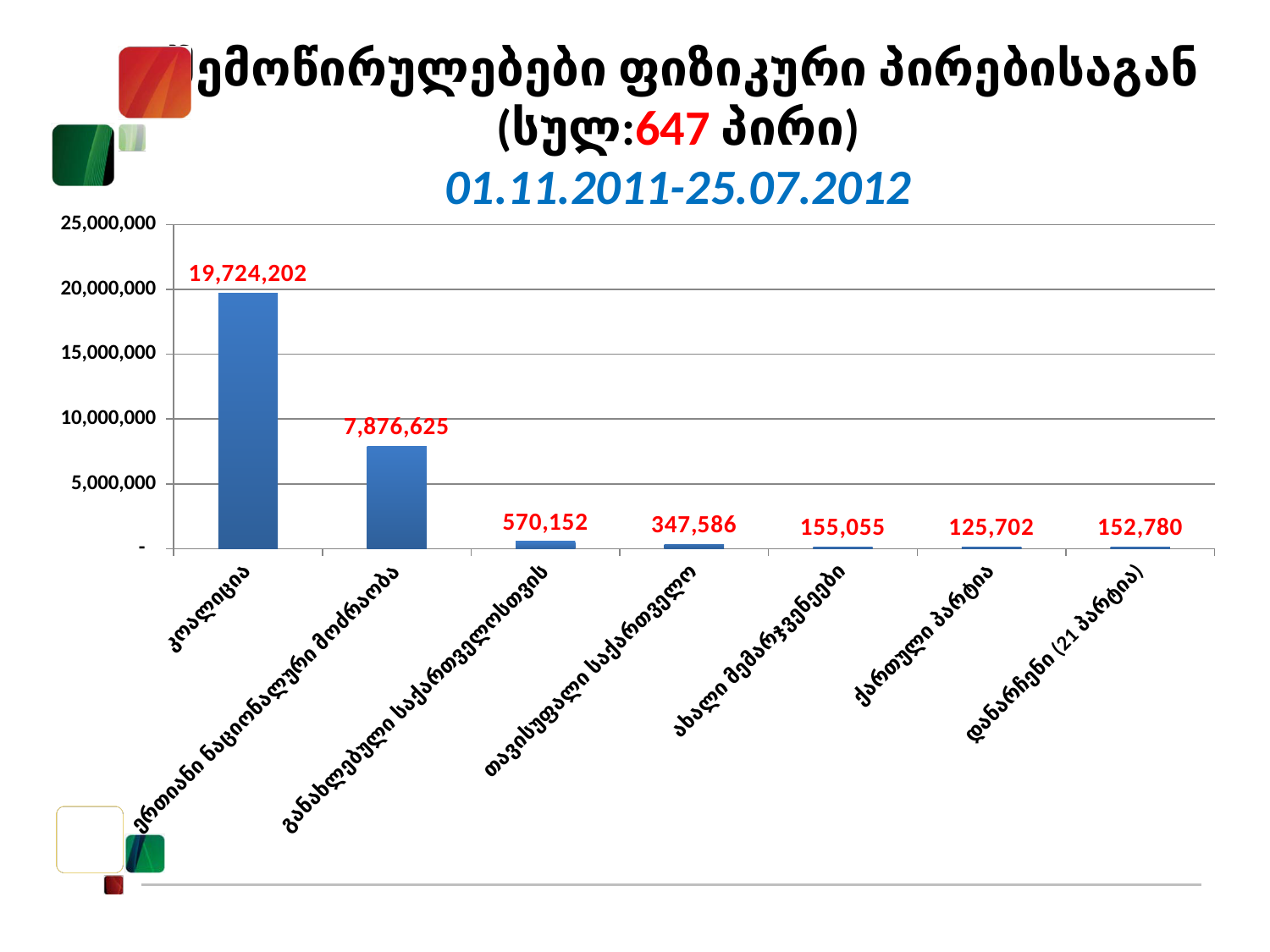
Which is larger, the value for განახლებული საქართველოსთვის or the value for ახალი მემარჯვენეები? განახლებული საქართველოსთვის Is the value for ერთიანი ნაციონალური მოძრაობა greater or less than 10,000,000? less What is the value for დანარჩენი (21 პარტია)? 152,780 What is the difference between the values for კოალიცია and ერთიანი ნაციონალური მოძრაობა? 11,847,577 What is the value for თავისუფალი საქართველო? 347,586 Which category has the highest value? კოალიცია What date range is shown in the chart title? 01.11.2011-25.07.2012 What is the value for კოალიცია? 19,724,202 Which category has the lowest value? ქართული პარტია How many categories (bars) are shown in the chart? 7 What type of chart is shown on the slide? bar chart What is the value for ერთიანი ნაციონალური მოძრაობა? 7,876,625